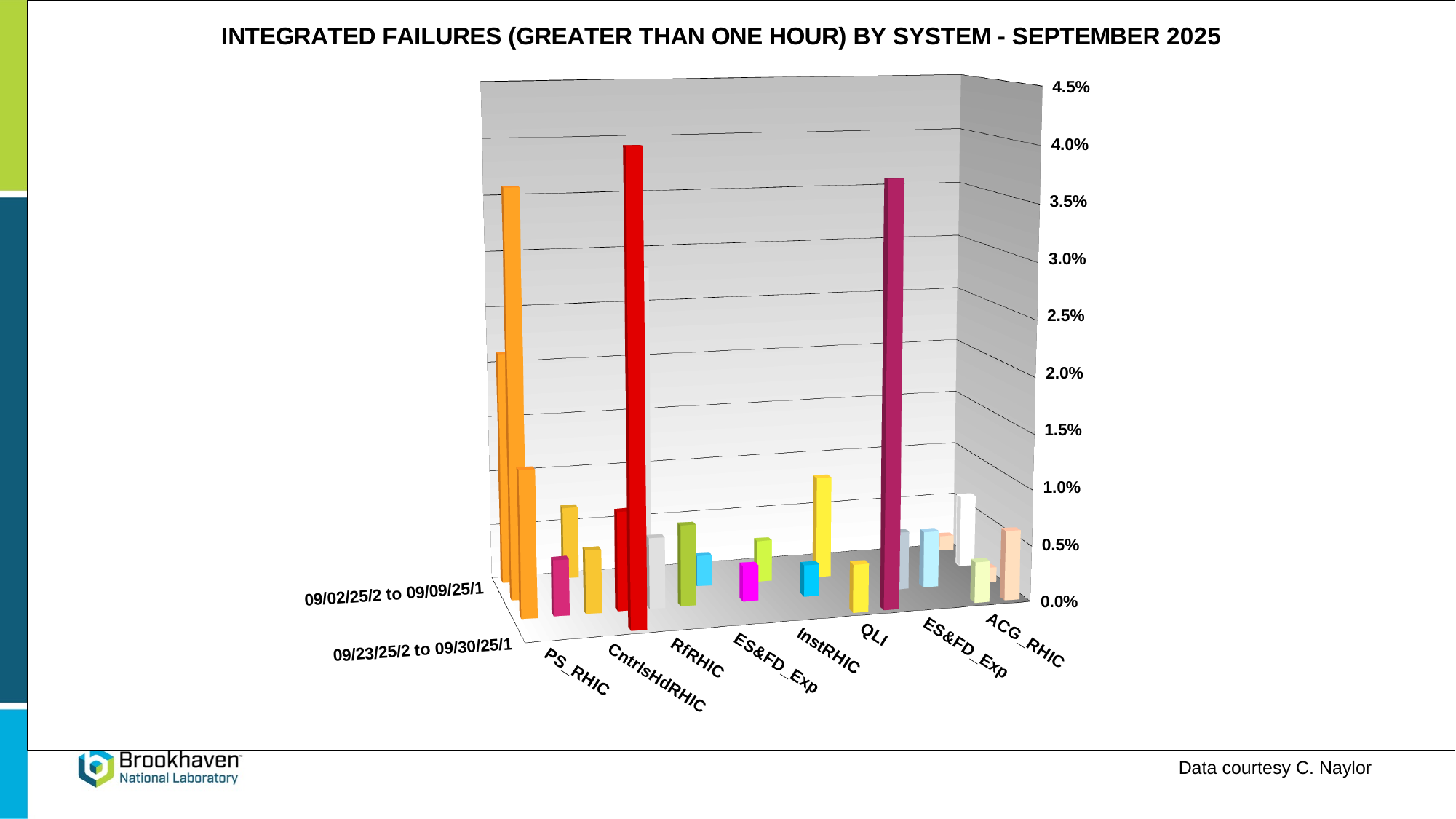
Is the tallest bar for PS_RHIC greater or less than 2.0%? greater What is the highest value shown on the vertical axis? 4.5% Which is larger, the tallest bar for QLI or the tallest bar for ACG_RHIC? QLI How many system categories are labelled along the x axis? 8 What is the title of the chart? INTEGRATED FAILURES (GREATER THAN ONE HOUR) BY SYSTEM - SEPTEMBER 2025 Is the tallest bar for InstRHIC greater or less than 1.5%? less What kind of chart is shown on the slide? bar chart Which is larger, the tallest bar for CntrlsHdRHIC or the tallest bar for InstRHIC? CntrlsHdRHIC Is the tallest bar for ACG_RHIC greater or less than 1.0%? less